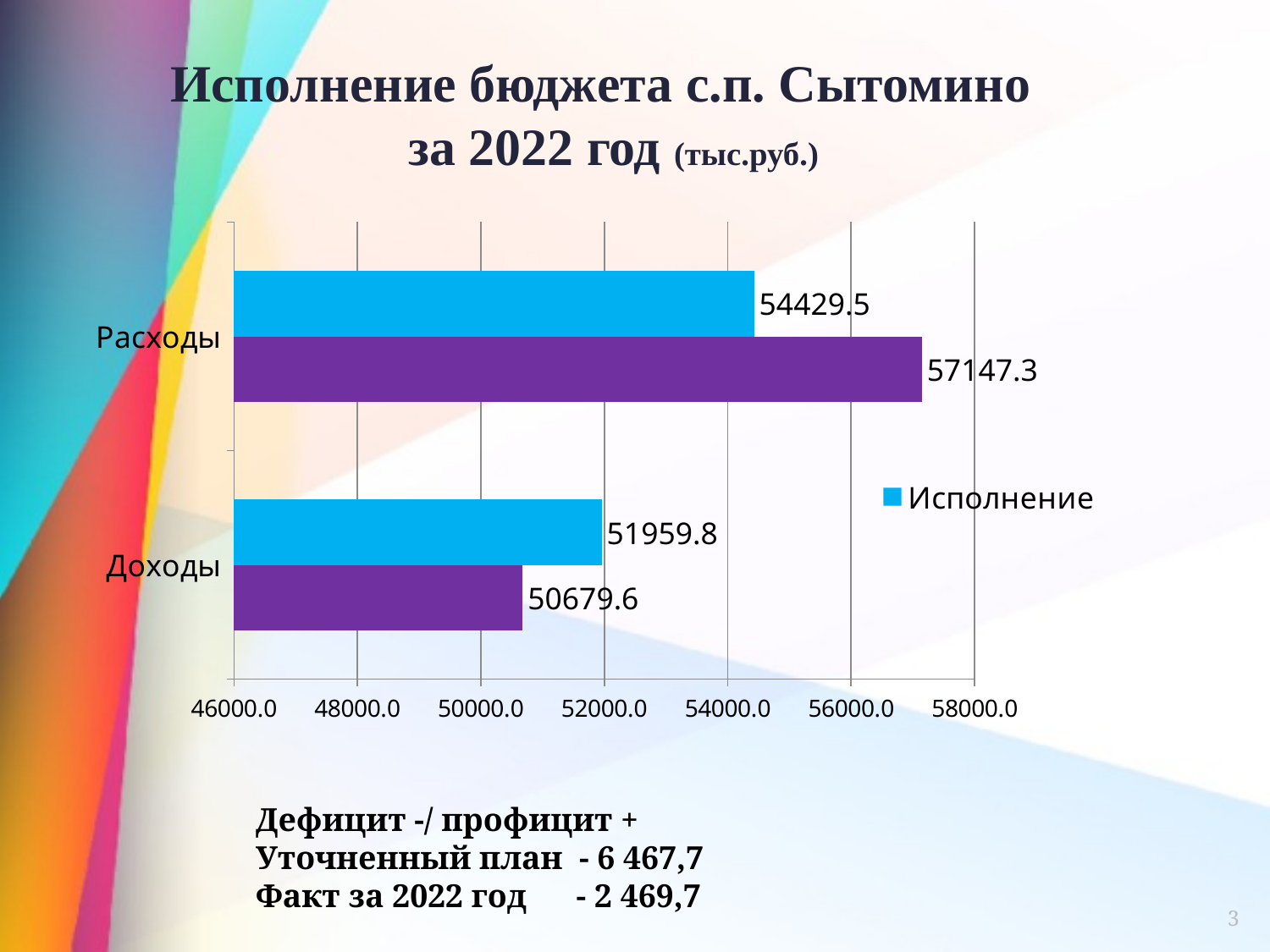
What kind of chart is shown on the slide? Bar chart What is the Исполнение value for Доходы? 51959.8 What value is shown on the purple bar for Расходы? 57147.3 What is the lowest value shown on the chart? 50679.6 What value is shown on the purple bar for Доходы? 50679.6 Is the Исполнение value for Доходы greater or less than 52000.0? less What is the highest value shown on the chart? 57147.3 Which category has the larger Исполнение value, Расходы or Доходы? Расходы What is the difference between the Исполнение bar and the purple bar for Доходы? 1280.2 How many categories are shown on the chart? 2 What is the Исполнение value for Расходы? 54429.5 What is the difference between the purple bar and the Исполнение bar for Расходы? 2717.8